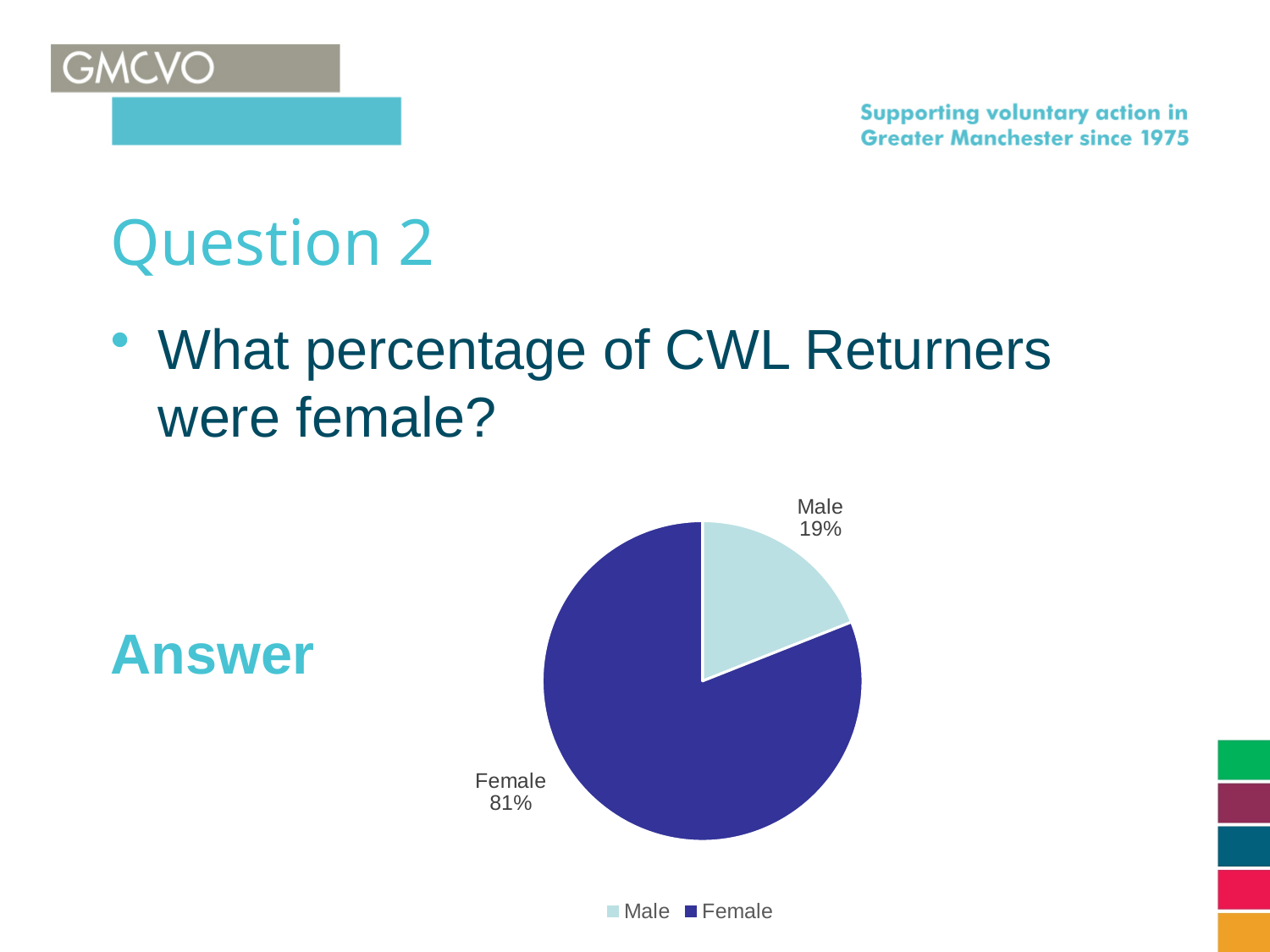
How many entries does the chart legend list? 2 Which colour represents the Female slice in the pie chart? Dark blue Which is larger in the pie chart, the Male slice or the Female slice? Female Which slice of the pie chart is the smallest? Male Which slice of the pie chart is the largest? Female What are the two categories listed in the chart legend? Male and Female What share of the pie does the Male slice represent? 19% What percentage of the pie chart is the Female slice? 81% What is the difference in percentage points between the Female and Male slices? 62 What kind of chart is shown on the slide? Pie chart How many slices does the pie chart have? 2 What percentage of the pie chart is the Male slice? 19%